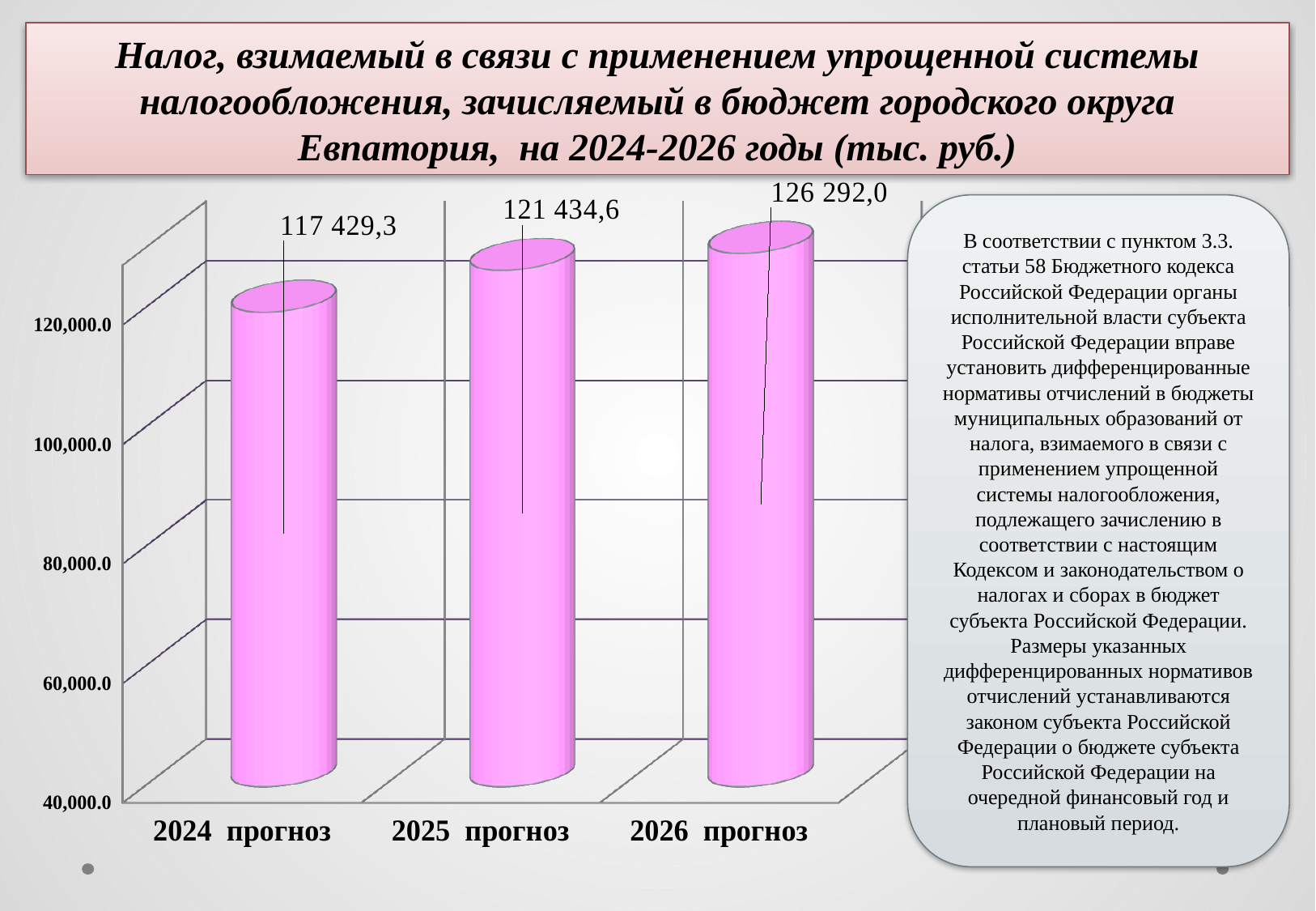
What is the difference between the values for 2026 прогноз and 2025 прогноз? 4 857,4 Which category has the lowest value? 2024 прогноз Do the values rise or fall from 2024 прогноз to 2026 прогноз? rise What kind of chart is shown on the slide? bar chart How many categories are shown on the chart? 3 What is the value for 2026 прогноз? 126 292,0 Is the value for 2024 прогноз greater or less than 100,000.0? greater Which category has the highest value? 2026 прогноз What is the value for 2024 прогноз? 117 429,3 Which is larger, the value for 2024 прогноз or the value for 2026 прогноз? 2026 прогноз What is the difference between the values for 2025 прогноз and 2024 прогноз? 4 005,3 What is the value for 2025 прогноз? 121 434,6